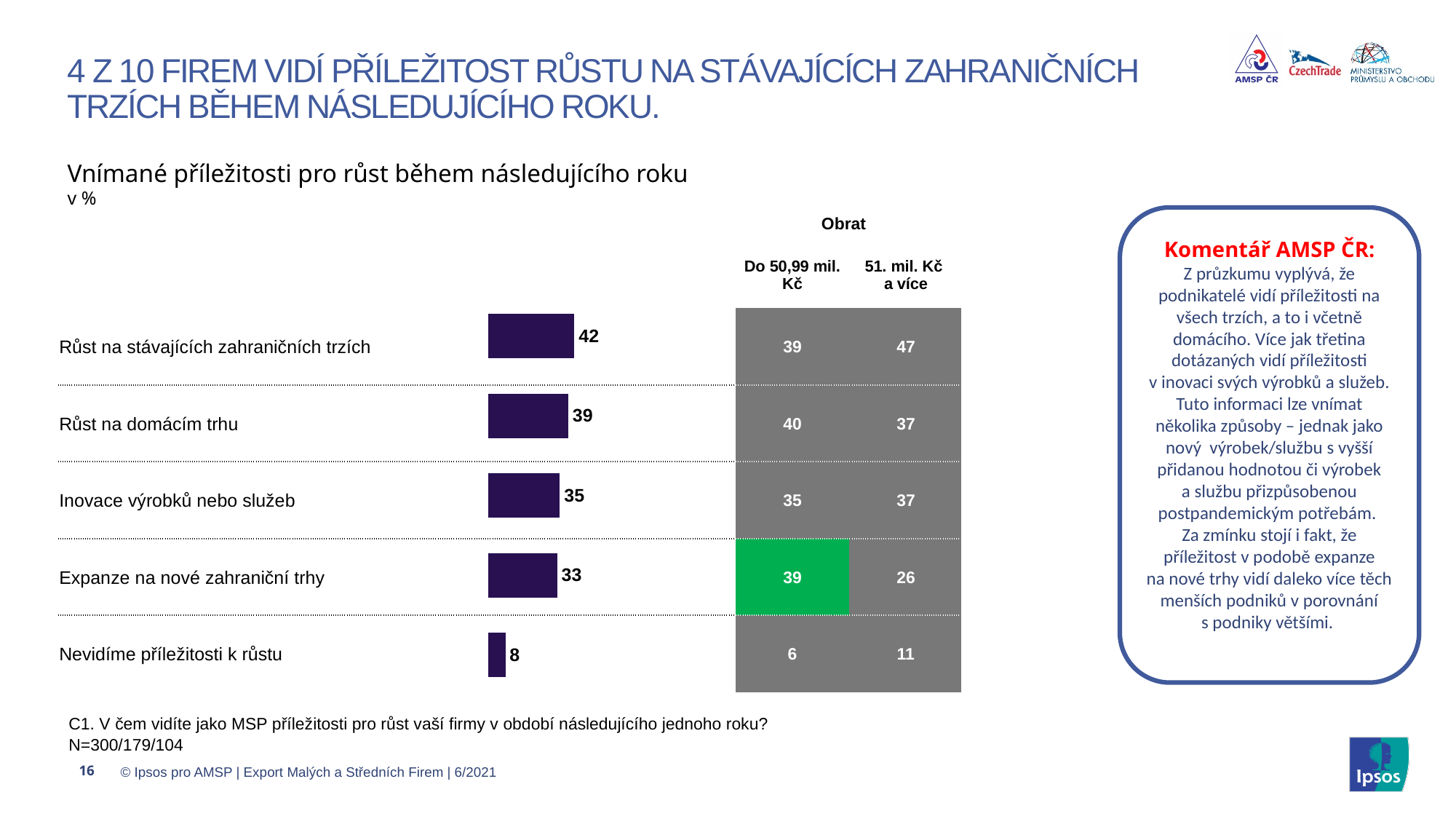
Which category has the highest value in the bar chart? Růst na stávajících zahraničních trzích What is the difference between the values for "Růst na domácím trhu" and "Inovace výrobků nebo služeb" in the bar chart? 4 In the table, what is the difference between the two turnover groups for "Expanze na nové zahraniční trhy"? 13 What is the title of the chart? Vnímané příležitosti pro růst během následujícího roku Which category has the lowest value in the bar chart? Nevidíme příležitosti k růstu In the table, what is the value for "Nevidíme příležitosti k růstu" among firms with turnover "51. mil. Kč a více"? 11 Which is larger in the bar chart: "Růst na domácím trhu" or "Expanze na nové zahraniční trhy"? Růst na domácím trhu How many categories are shown in the bar chart? 5 What is the value for "Expanze na nové zahraniční trhy" in the bar chart? 33 What is the value for "Růst na stávajících zahraničních trzích" in the bar chart? 42 What kind of chart is shown on the slide? Bar chart In the table, what is the value for "Expanze na nové zahraniční trhy" among firms with turnover "Do 50,99 mil. Kč"? 39